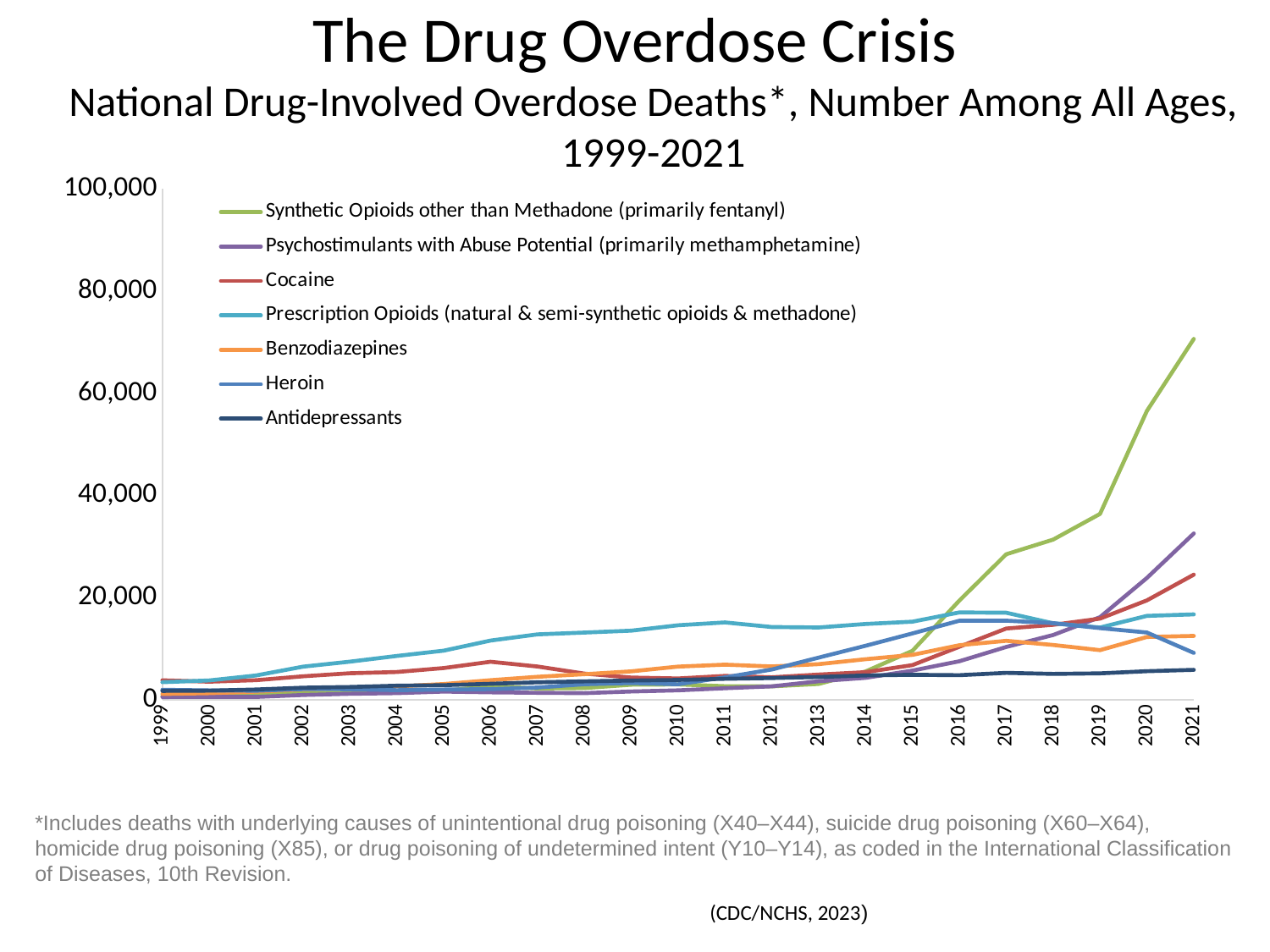
Which series has the lowest value in 2021? Antidepressants What is the source cited below the chart? CDC/NCHS, 2023 Is the value for Psychostimulants with Abuse Potential in 2021 greater or less than 20,000? greater What kind of chart is shown on the slide? line chart Does the Synthetic Opioids other than Methadone line rise or fall from 2014 to 2021? rise In 2021, which is larger: the value for Cocaine or the value for Synthetic Opioids other than Methadone? Synthetic Opioids other than Methadone Which series has the highest value in 2021? Synthetic Opioids other than Methadone (primarily fentanyl) Is the value for Heroin in 2021 greater or less than 20,000? less Does the Heroin line rise or fall from 2019 to 2021? fall How many years are shown along the x axis? 23 Is the value for Synthetic Opioids other than Methadone in 2021 greater or less than 60,000? greater How many series does the legend list? 7